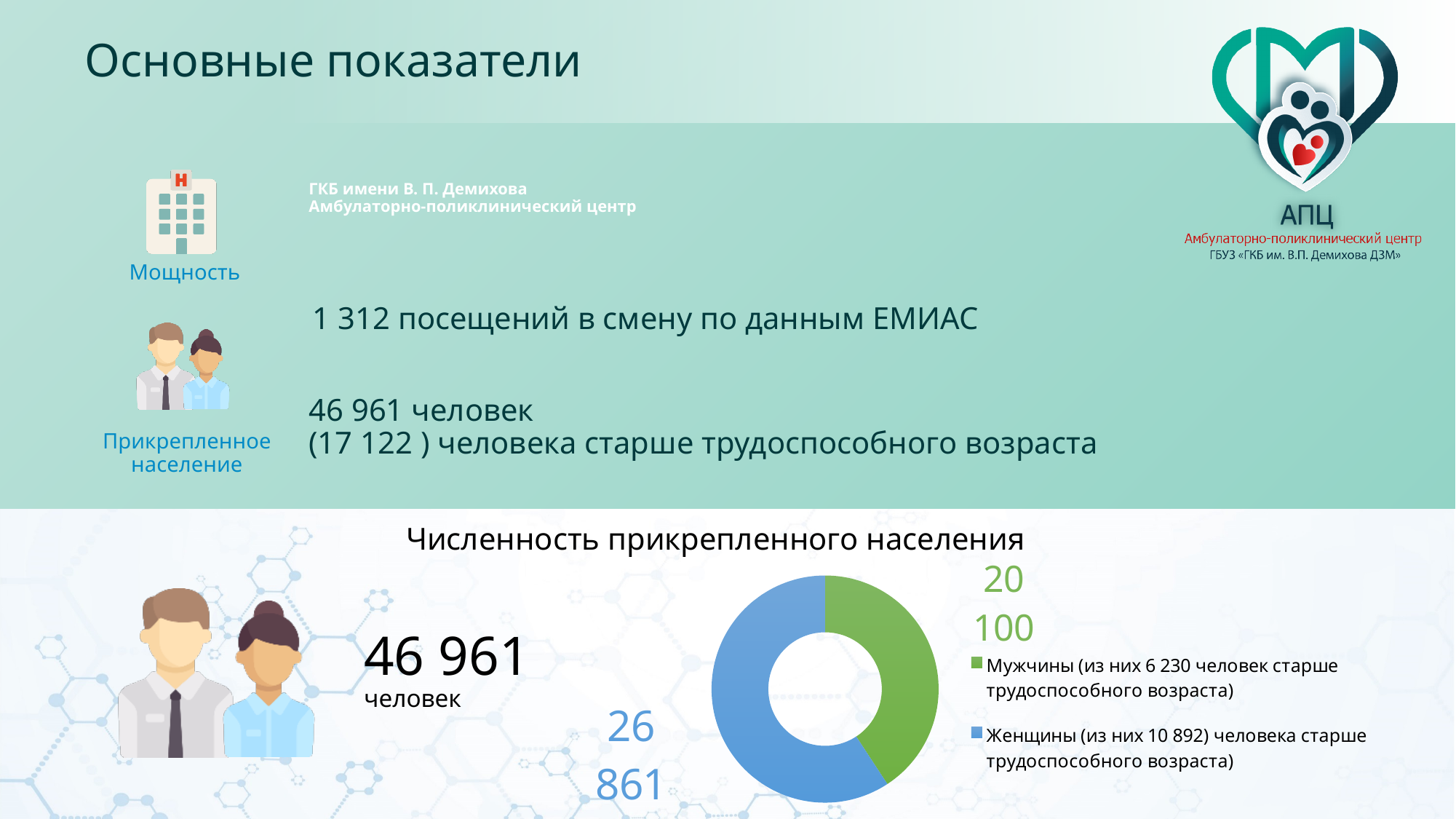
What colour represents Мужчины in the chart 'Численность прикрепленного населения'? Green In the chart 'Численность прикрепленного населения', which is larger: Мужчины or Женщины? Женщины Which category has the smallest slice in the chart 'Численность прикрепленного населения'? Мужчины What type of chart is 'Численность прикрепленного населения'? Doughnut (pie) chart How many categories does the chart 'Численность прикрепленного населения' show? 2 How many entries does the legend of the chart 'Численность прикрепленного населения' list? 2 Which category has the largest slice in the chart 'Численность прикрепленного населения'? Женщины What value is shown for Женщины in the chart 'Численность прикрепленного населения'? 26 861 What value is shown for Мужчины in the chart 'Численность прикрепленного населения'? 20 100 What is the total of the two slices in the chart 'Численность прикрепленного населения'? 46 961 In the chart 'Численность прикрепленного населения', by how much does the value for Женщины exceed the value for Мужчины? 6 761 What share of the total does the Женщины slice represent in the chart 'Численность прикрепленного населения'? 57.2%